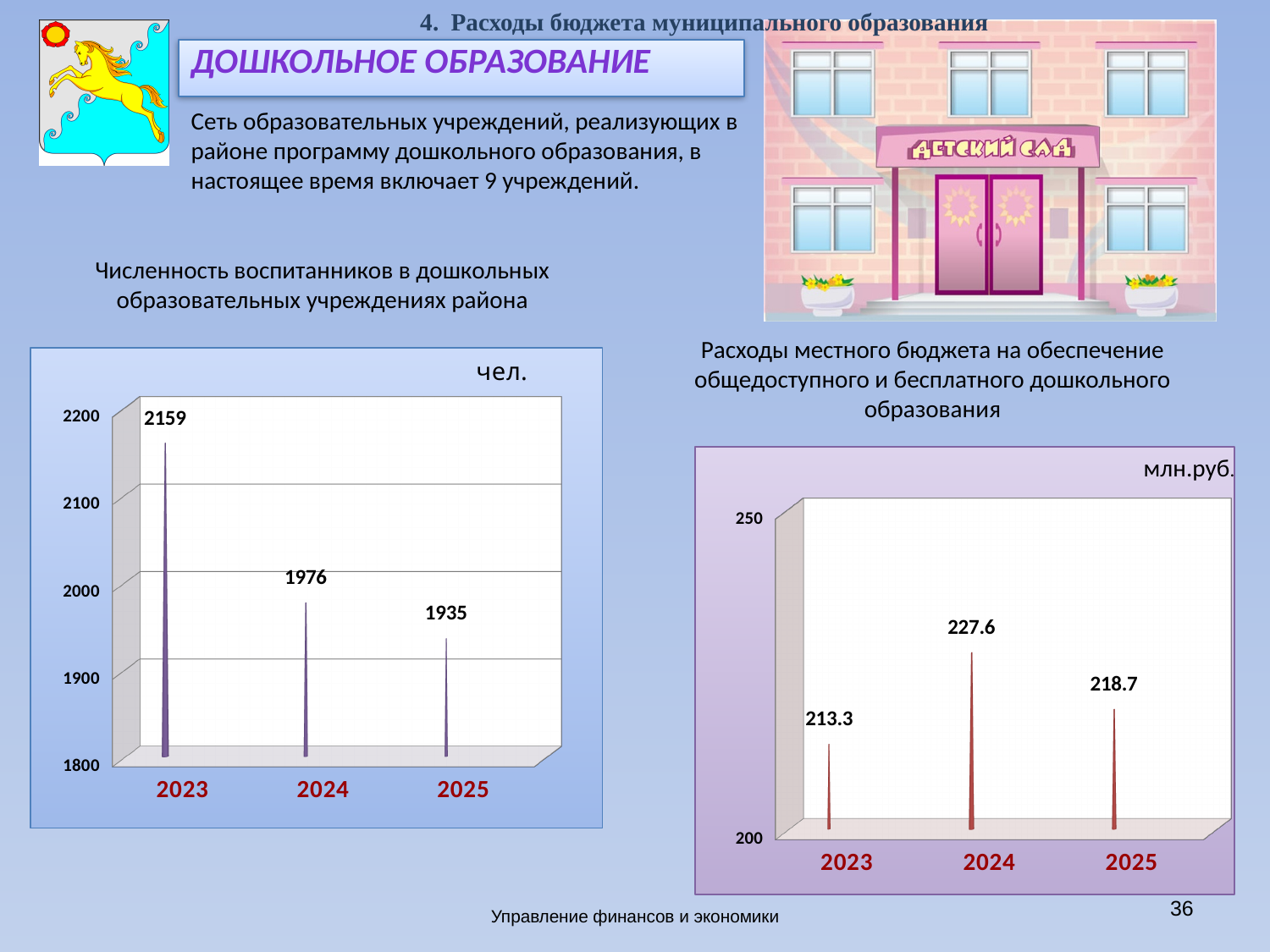
In the chart 'Расходы местного бюджета на обеспечение общедоступного и бесплатного дошкольного образования', how many years are shown on the x axis? 3 In the chart 'Расходы местного бюджета на обеспечение общедоступного и бесплатного дошкольного образования', what is the value for 2023? 213.3 In the chart 'Расходы местного бюджета на обеспечение общедоступного и бесплатного дошкольного образования', which year has the lowest value? 2023 In the chart 'Численность воспитанников в дошкольных образовательных учреждениях района', what unit is shown in the top right corner of the chart? чел. In the chart 'Численность воспитанников в дошкольных образовательных учреждениях района', what is the value for 2023? 2159 In the chart 'Численность воспитанников в дошкольных образовательных учреждениях района', do the values rise or fall from 2023 to 2025? fall In the chart 'Расходы местного бюджета на обеспечение общедоступного и бесплатного дошкольного образования', what is the value for 2024? 227.6 In the chart 'Численность воспитанников в дошкольных образовательных учреждениях района', which year has the highest value? 2023 In the chart 'Расходы местного бюджета на обеспечение общедоступного и бесплатного дошкольного образования', which is larger, the value for 2024 or the value for 2025? 2024 What kind of chart is the chart 'Расходы местного бюджета на обеспечение общедоступного и бесплатного дошкольного образования'? bar chart In the chart 'Численность воспитанников в дошкольных образовательных учреждениях района', what is the value for 2025? 1935 In the chart 'Численность воспитанников в дошкольных образовательных учреждениях района', what is the difference between the values for 2023 and 2024? 183